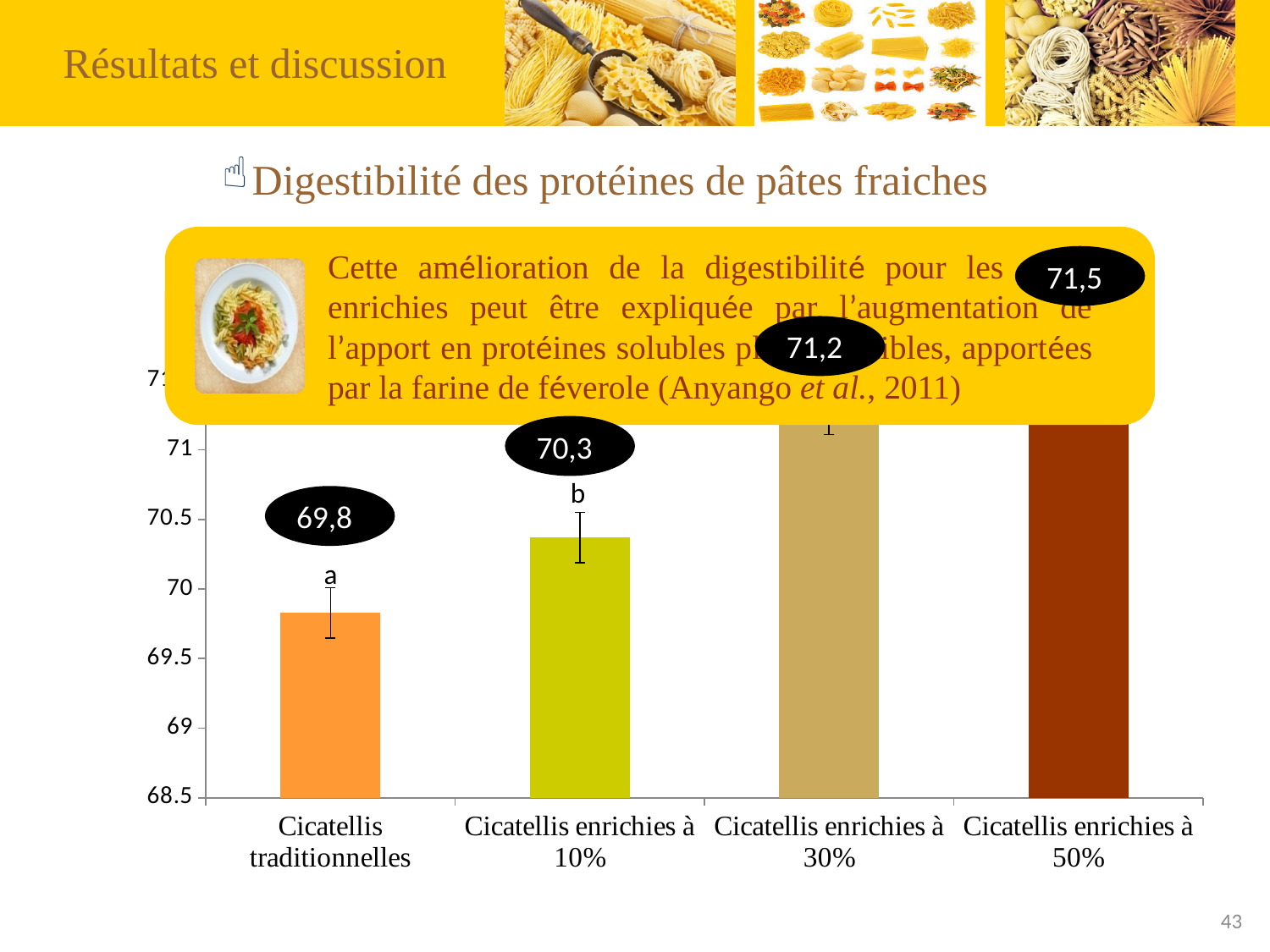
What is the difference between the values for Cicatellis enrichies à 10% and Cicatellis traditionnelles? 0,5 Which is larger, the value for Cicatellis enrichies à 30% or Cicatellis enrichies à 10%? Cicatellis enrichies à 30% What is the value shown for Cicatellis enrichies à 10%? 70,3 Do the values rise or fall from left to right along the x axis? rise Is the value for Cicatellis traditionnelles greater or less than 70? less Which category has the lowest value? Cicatellis traditionnelles Which category has the highest value? Cicatellis enrichies à 50% What is the digestibility value shown for Cicatellis traditionnelles? 69,8 What is the difference between the values for Cicatellis enrichies à 50% and Cicatellis traditionnelles? 1,7 What is the value shown for Cicatellis enrichies à 30%? 71,2 How many categories are shown on the x axis of the chart? 4 What is the value shown for Cicatellis enrichies à 50%? 71,5